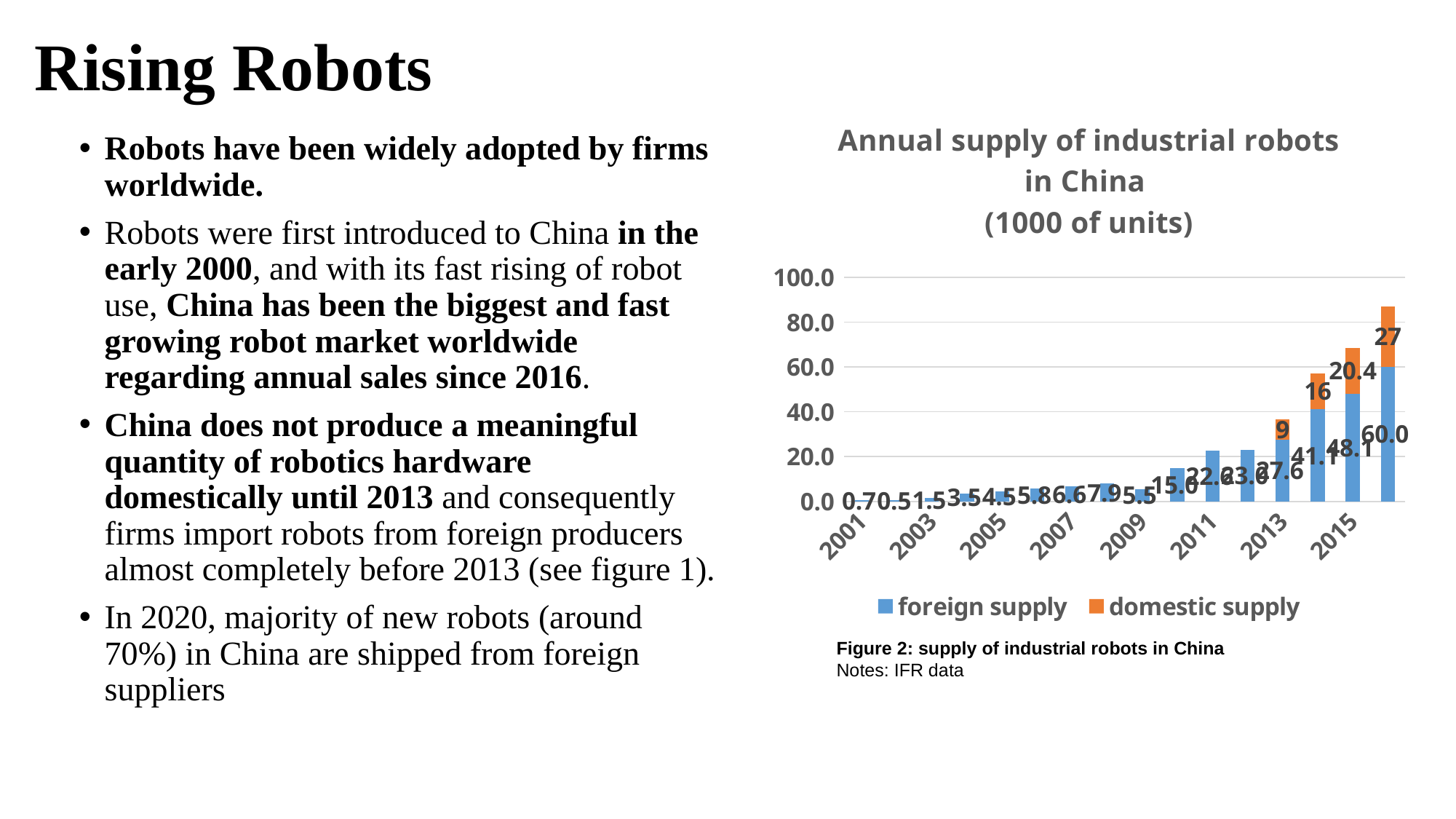
Which year has the highest foreign supply? 2016 What is the domestic supply value for 2016? 27 What is the domestic supply value for 2015? 20.4 What is the total supply (foreign plus domestic) for 2015? 68.5 How many series does the legend of the chart list? 2 Is the total supply for 2016 greater or less than 80.0? greater What kind of chart is shown on the slide? bar chart Does the foreign supply generally rise or fall from 2001 to 2016? rise What is the difference between the foreign supply in 2016 and in 2015? 11.9 What is the foreign supply value for 2016? 60.0 What is the domestic supply value for 2013? 9 What is the foreign supply value for 2014? 41.1